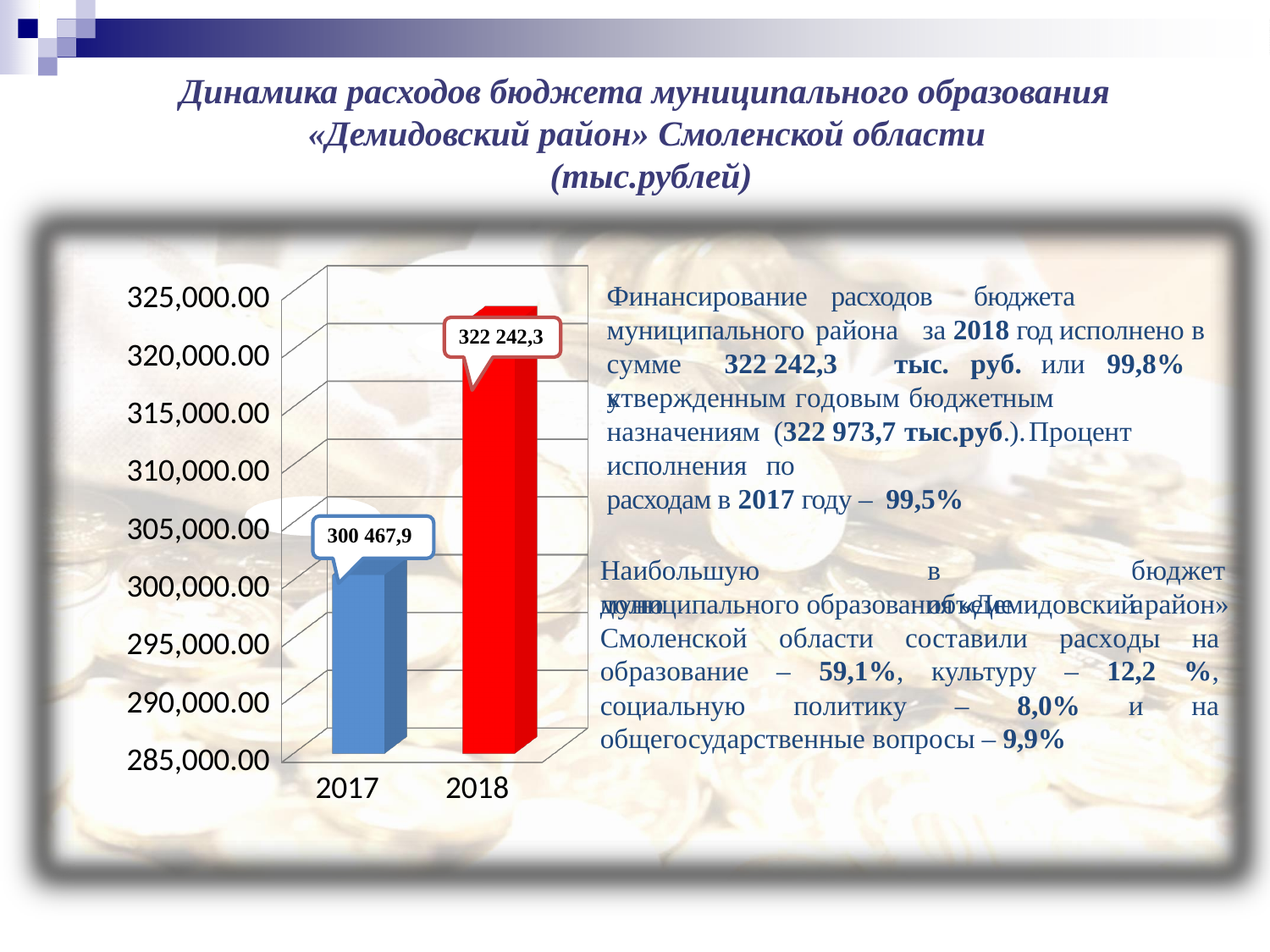
What is the value shown for 2018 on the chart? 322 242,3 Which year has the lower bar on the chart? 2017 Which year has the higher bar on the chart? 2018 Is the value for 2017 greater or less than 305,000.00? less What is the value shown for 2017 on the chart? 300 467,9 What kind of chart is shown on the slide? bar chart What colour is the bar for 2018? red By how much does the 2018 value exceed the 2017 value on the chart? 21 774,4 Is the value for 2017 larger or smaller than the value for 2018? smaller How many years (categories) are plotted on the chart? 2 Do the values rise or fall from 2017 to 2018? rise Is the value for 2018 greater or less than 320,000.00? greater